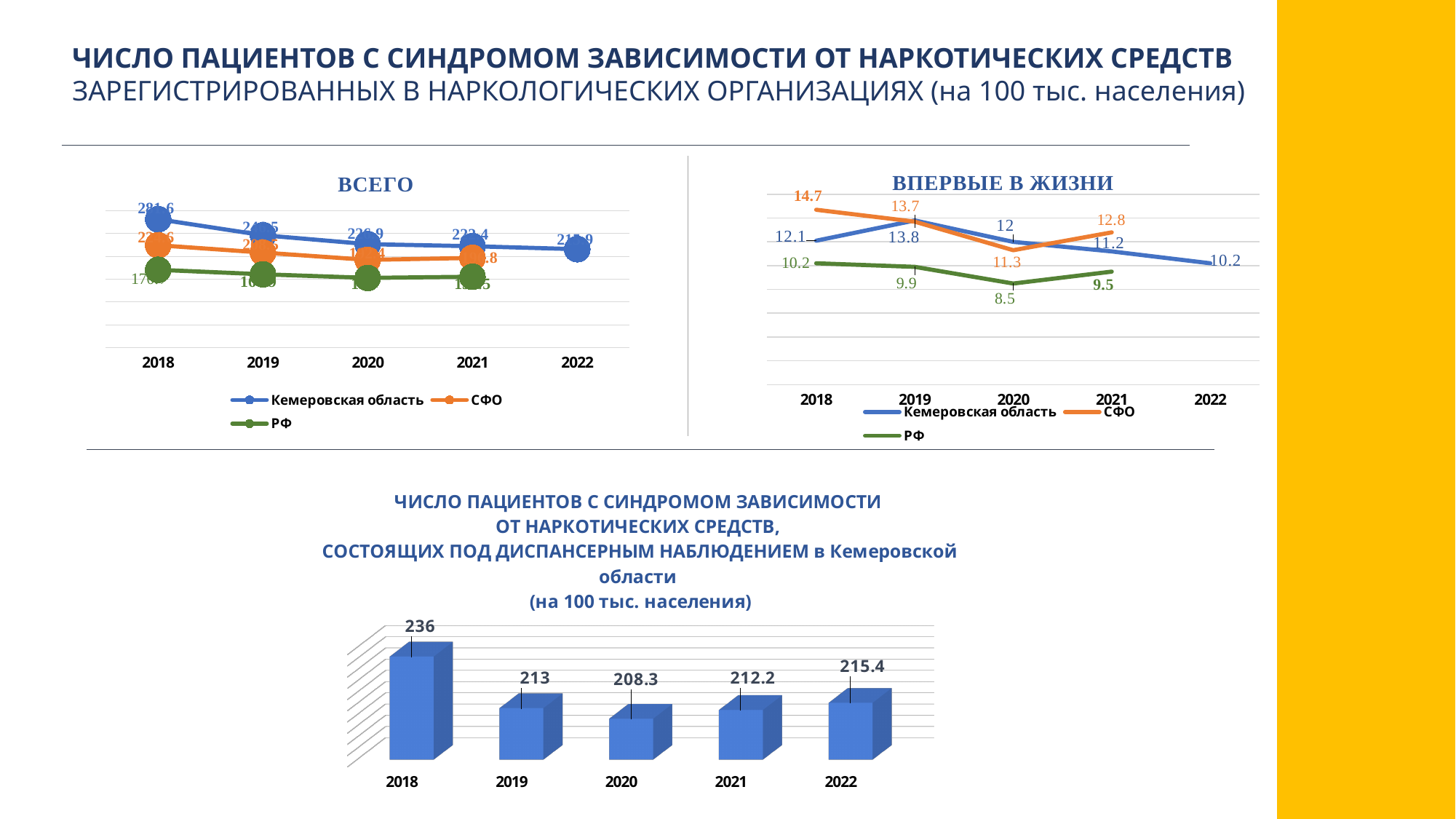
In the bottom bar chart (patients under dispensary observation in Kemerovo region), which year has the lowest value? 2020 In the bottom bar chart (patients under dispensary observation in Kemerovo region), which year has the highest value? 2018 In the chart titled 'ВПЕРВЫЕ В ЖИЗНИ', what is the value for СФО in 2018? 14.7 In the chart titled 'ВПЕРВЫЕ В ЖИЗНИ', what is the value for Кемеровская область in 2022? 10.2 In the bottom bar chart (patients under dispensary observation in Kemerovo region), what is the difference between the 2018 and 2019 values? 23 In the chart titled 'ВСЕГО', what is the value for Кемеровская область in 2018? 281.6 In the chart titled 'ВПЕРВЫЕ В ЖИЗНИ', in which year is the РФ value lowest? 2020 In the chart titled 'ВПЕРВЫЕ В ЖИЗНИ', how many series does the legend list? 3 In the bottom bar chart (patients under dispensary observation in Kemerovo region), what is the value for 2018? 236 What type of chart is the bottom chart on the slide? Bar chart In the bottom bar chart (patients under dispensary observation in Kemerovo region), how many years are shown? 5 In the bottom bar chart (patients under dispensary observation in Kemerovo region), what is the value for 2020? 208.3